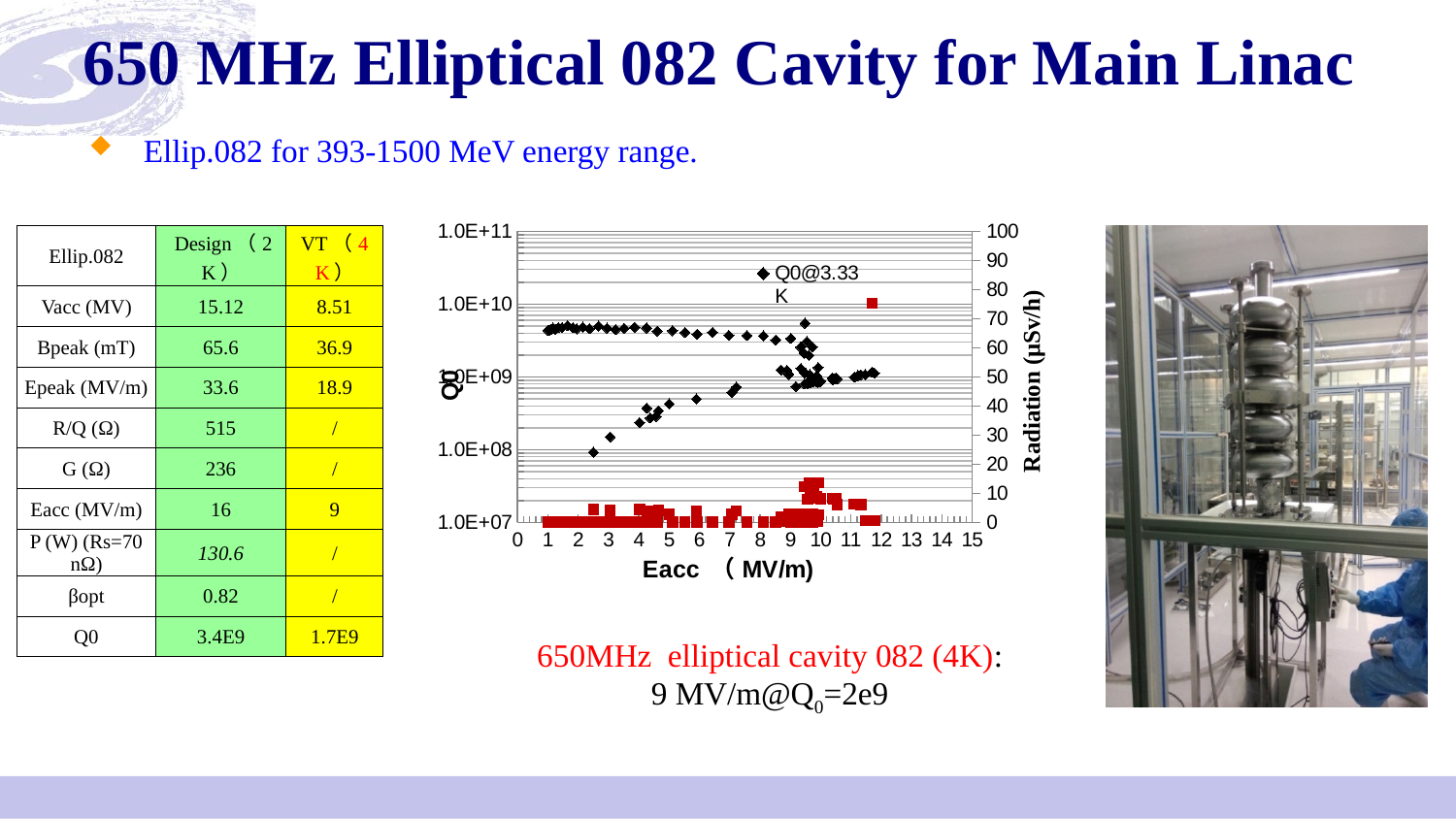
What is the lowest tick value shown on the left y axis of the chart? 1.0E+07 Is the radiation value (red squares) at Eacc of about 5 MV/m greater or less than 10 μSv/h? less What is the highest tick value shown on the right y axis of the chart? 100 Is the radiation value (red squares) at Eacc of about 11.8 MV/m greater or less than 70 μSv/h? greater What is the label of the right-hand y axis of the chart? Radiation (μSv/h) How many tick labels are shown on the x axis of the chart? 16 What kind of chart is shown in the middle of the slide? scatter chart What is the largest Eacc value labelled on the x axis of the chart? 15 What is the label of the x axis of the chart? Eacc (MV/m) What is the highest tick value shown on the left y axis of the chart? 1.0E+11 Is the Q0 value (black diamonds) at Eacc of about 1 MV/m greater or less than 1.0E+09? greater